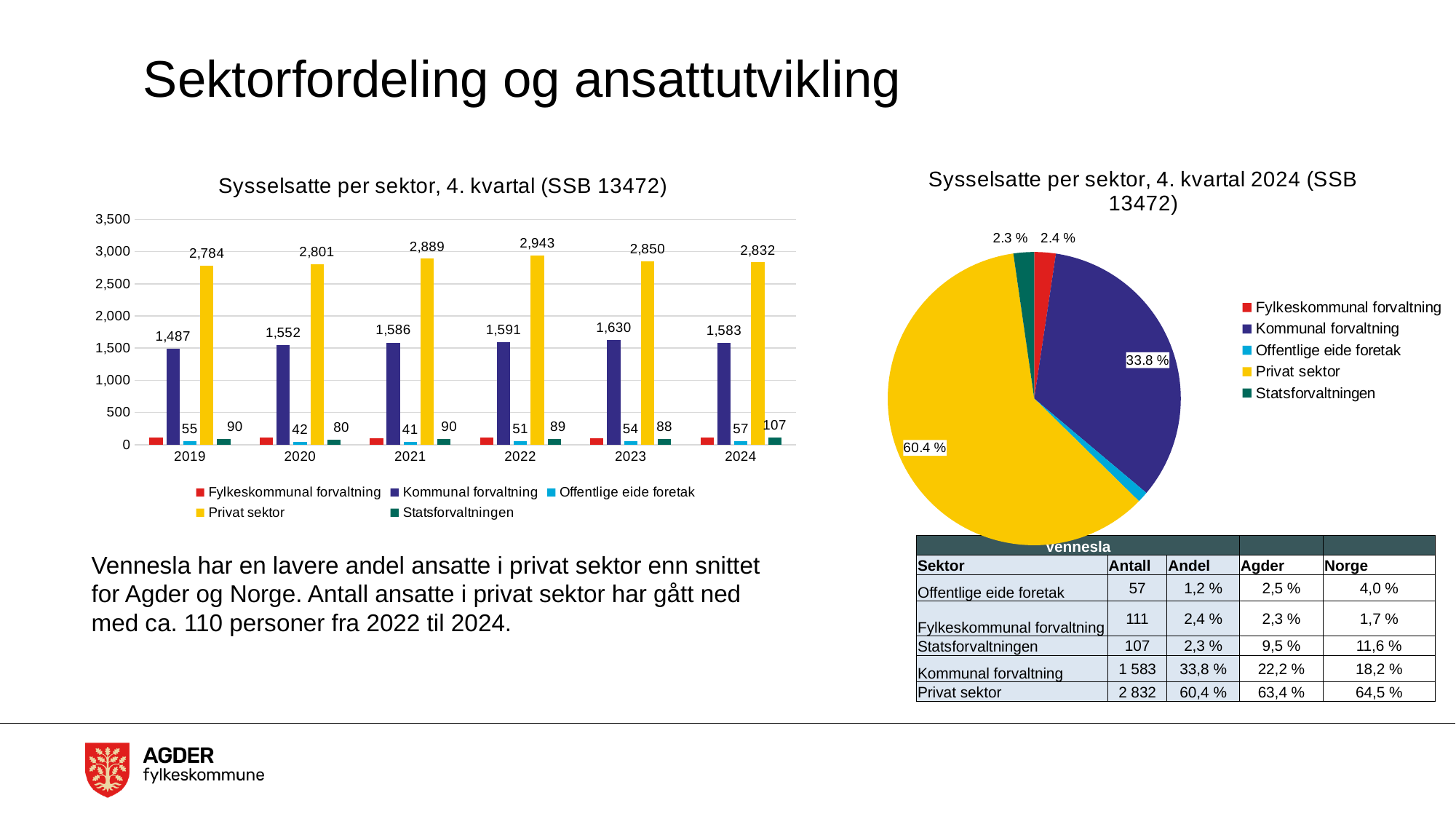
In the bar chart 'Sysselsatte per sektor, 4. kvartal (SSB 13472)', what is the value for Privat sektor in 2022? 2,943 In the bar chart 'Sysselsatte per sektor, 4. kvartal (SSB 13472)', what is the difference between Privat sektor in 2022 and in 2024? 111 In the bar chart 'Sysselsatte per sektor, 4. kvartal (SSB 13472)', in which year is Privat sektor highest? 2022 In the bar chart 'Sysselsatte per sektor, 4. kvartal (SSB 13472)', what is the value for Kommunal forvaltning in 2019? 1,487 In the pie chart 'Sysselsatte per sektor, 4. kvartal 2024 (SSB 13472)', what share does Privat sektor have? 60.4 % In the bar chart 'Sysselsatte per sektor, 4. kvartal (SSB 13472)', in which year is Offentlige eide foretak lowest? 2021 In the bar chart 'Sysselsatte per sektor, 4. kvartal (SSB 13472)', which year has the larger value for Kommunal forvaltning, 2023 or 2024? 2023 In the bar chart 'Sysselsatte per sektor, 4. kvartal (SSB 13472)', how many series does the legend list? 5 In the bar chart 'Sysselsatte per sektor, 4. kvartal (SSB 13472)', is the value for Fylkeskommunal forvaltning in 2024 greater or less than 500? less In the pie chart 'Sysselsatte per sektor, 4. kvartal 2024 (SSB 13472)', what share does Kommunal forvaltning have? 33.8 % In the bar chart 'Sysselsatte per sektor, 4. kvartal (SSB 13472)', how many years are shown on the x axis? 6 In the bar chart 'Sysselsatte per sektor, 4. kvartal (SSB 13472)', what is the value for Statsforvaltningen in 2024? 107